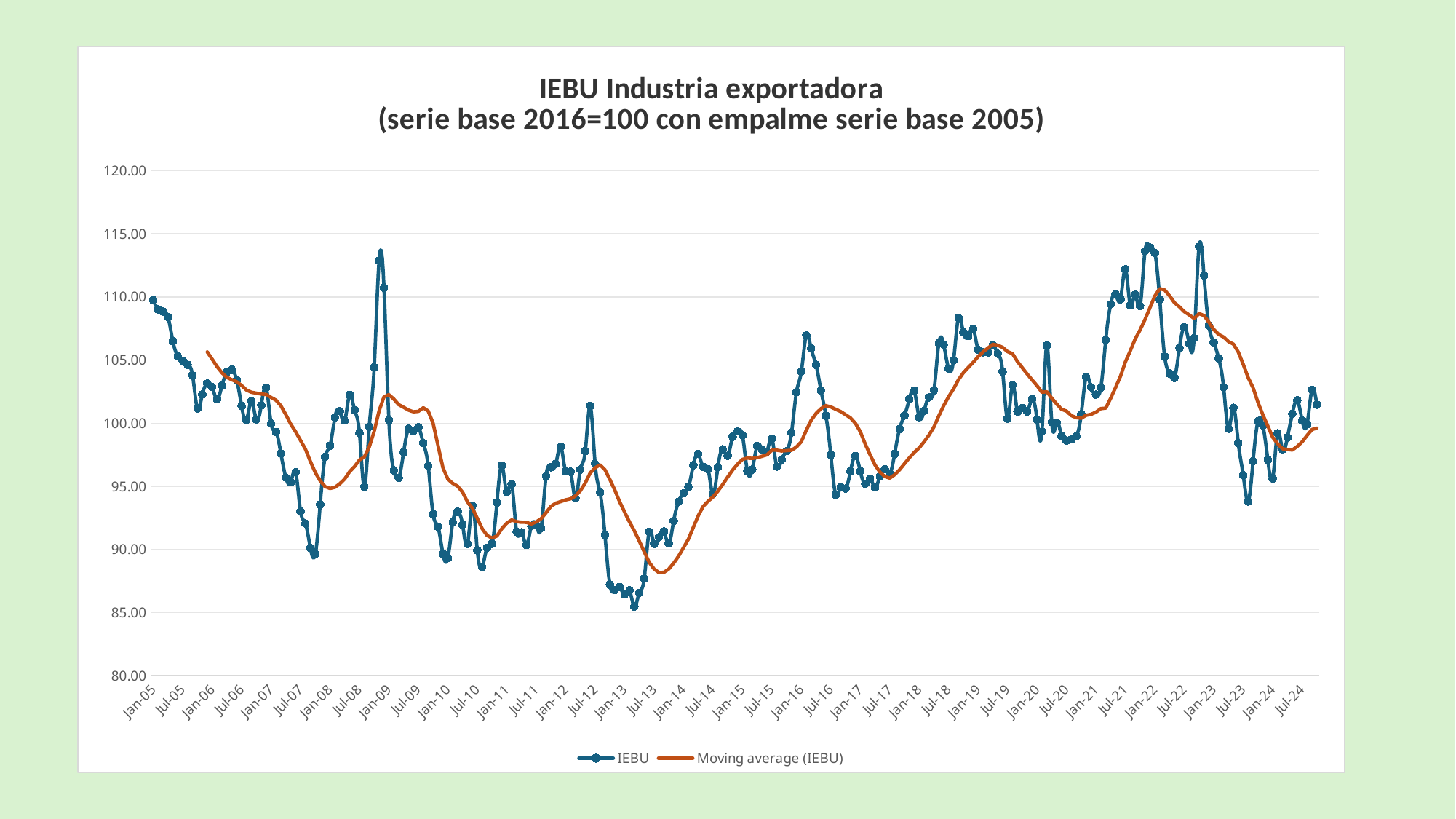
Is the IEBU value at Jan-09 greater or less than 110? less What is the title of the chart? IEBU Industria exportadora (serie base 2016=100 con empalme serie base 2005) Which is larger, the IEBU value at Jan-13 or at Jan-22? Jan-22 Which series is drawn in orange according to the legend? Moving average (IEBU) What kind of chart is shown on the slide? Line chart Is the Moving average (IEBU) value at Jul-13 greater or less than 90? less Is the IEBU value at Jan-22 greater or less than 110? greater Does the IEBU series rise or fall between Jan-13 and Jan-16? rise How many series does the legend list? 2